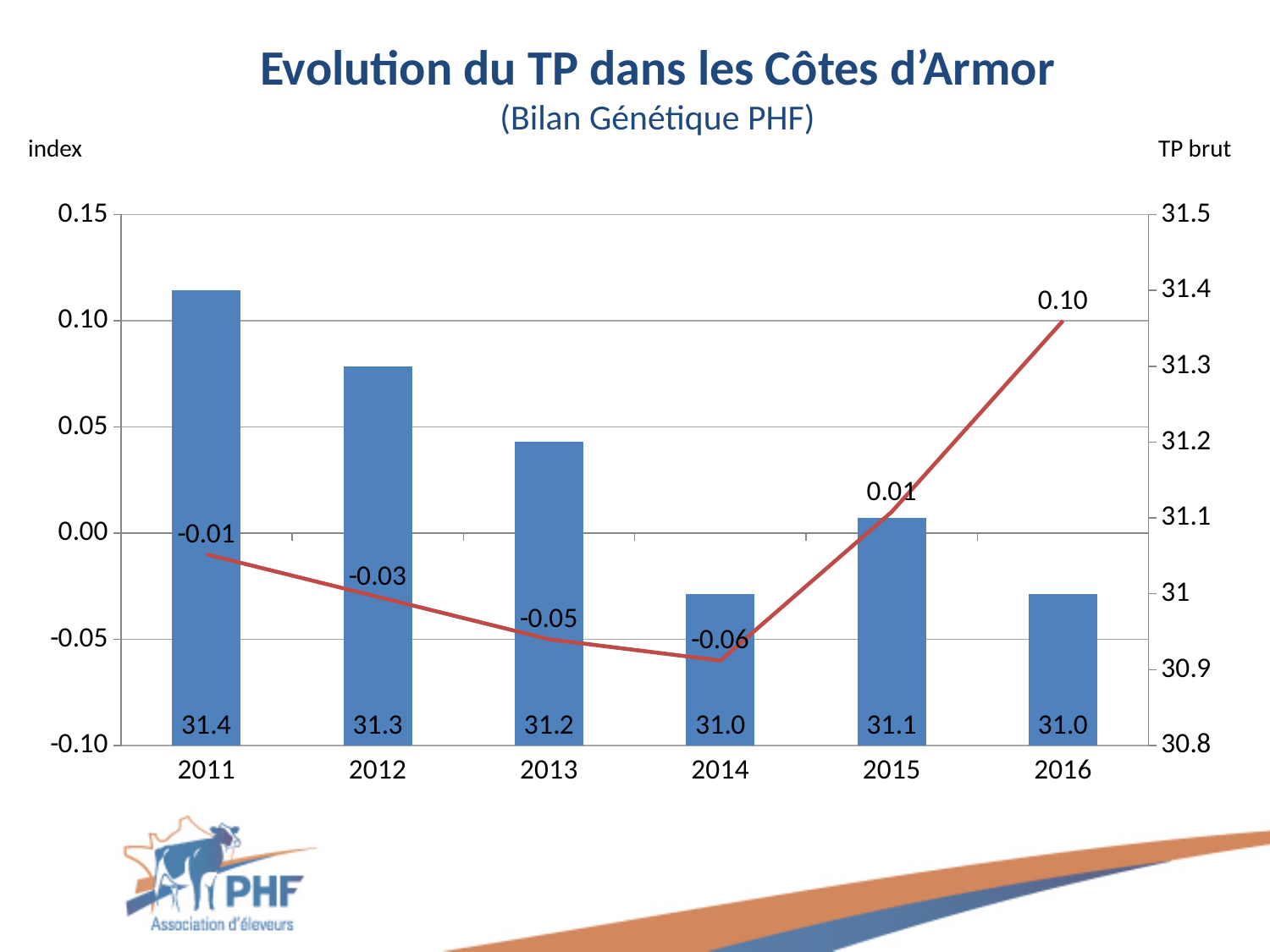
What index value does the line show for 2016? 0.10 What is the difference between the TP brut values for 2011 and 2014? 0.4 What is the TP brut value shown on the bar for 2011? 31.4 What is the title of the chart? Evolution du TP dans les Côtes d'Armor What index value does the line show for 2014? -0.06 Which year has the highest TP brut bar? 2011 Which is larger, the TP brut bar for 2012 or for 2013? 2012 In which year is the index line at its highest value? 2016 In which year is the index line at its lowest value? 2014 Does the index line rise or fall from 2011 to 2014? fall How many years are shown on the x axis? 6 What is the TP brut value shown on the bar for 2015? 31.1